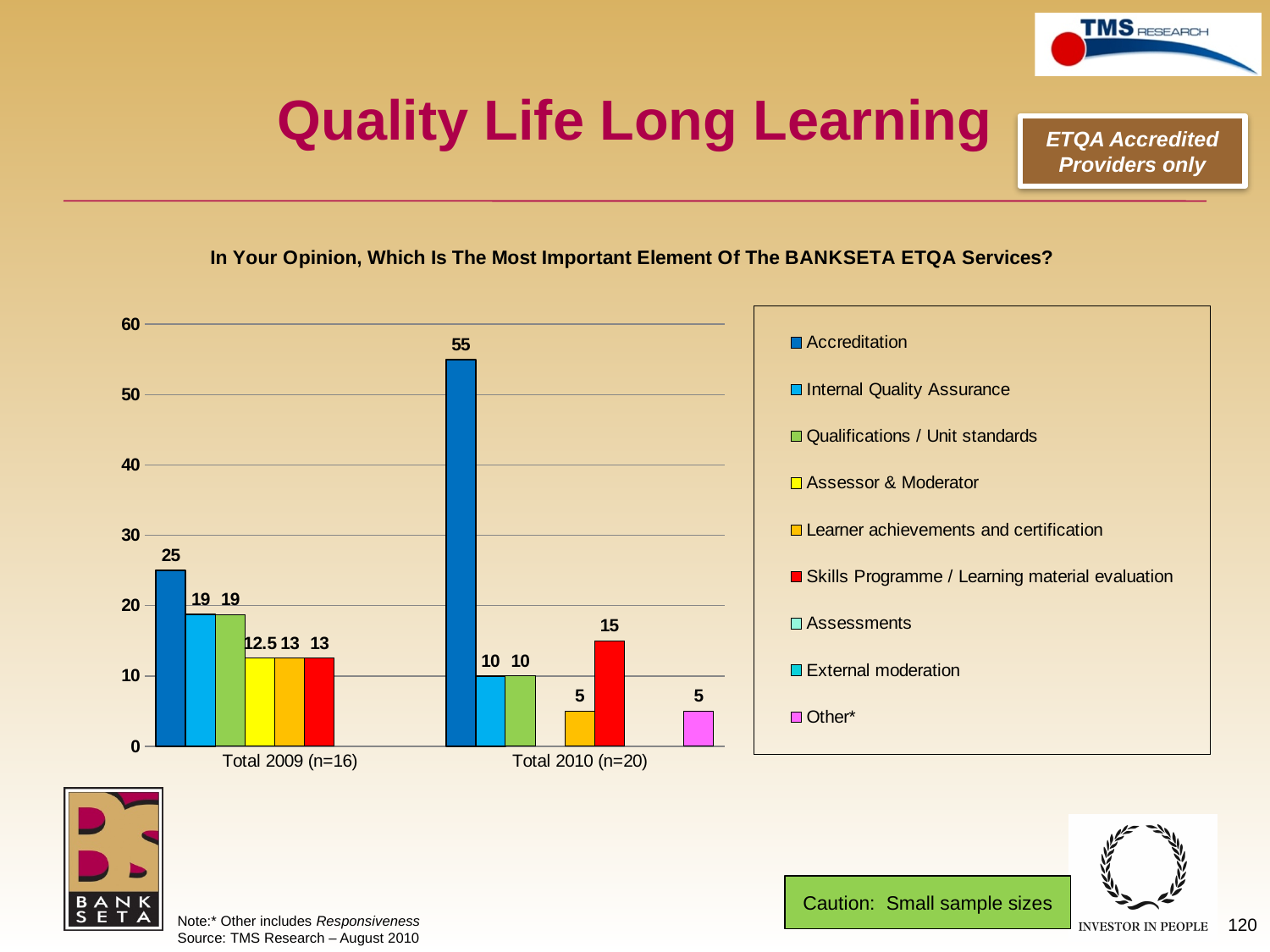
By how much did the value for Accreditation increase from Total 2009 (n=16) to Total 2010 (n=20)? 30 What kind of chart is shown on the slide? bar chart What value is shown for Other* in Total 2010 (n=20)? 5 How many category groups are shown on the x axis? 2 How many series does the legend list? 9 What value is shown for Accreditation in Total 2010 (n=20)? 55 What value is shown for Accreditation in Total 2009 (n=16)? 25 Did the value for Internal Quality Assurance rise or fall from Total 2009 (n=16) to Total 2010 (n=20)? fall What value is shown for Skills Programme / Learning material evaluation in Total 2010 (n=20)? 15 What value is shown for Assessor & Moderator in Total 2009 (n=16)? 12.5 Is the value for Skills Programme / Learning material evaluation larger in Total 2009 (n=16) or Total 2010 (n=20)? Total 2010 (n=20) Which element has the highest value in Total 2010 (n=20)? Accreditation